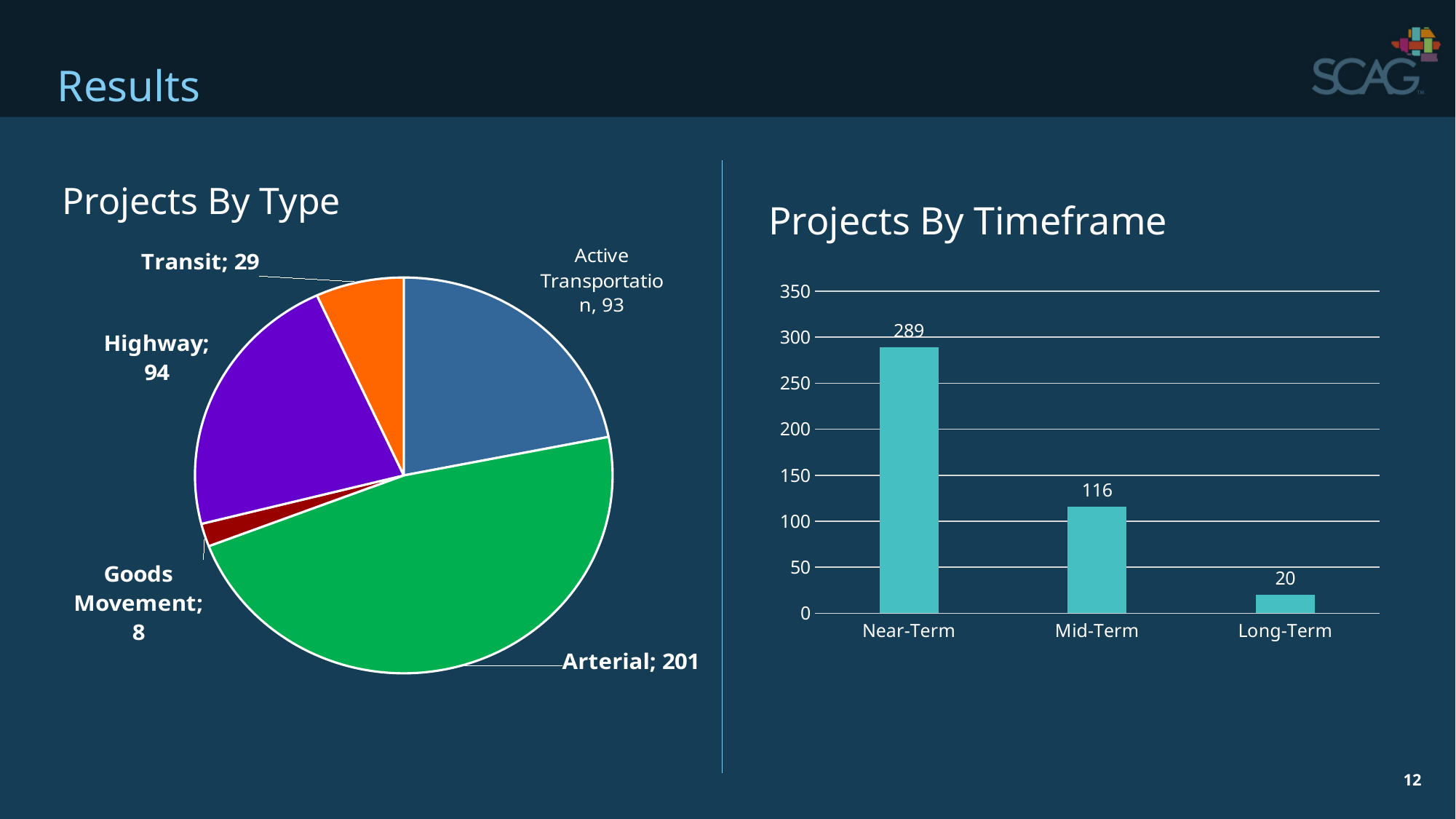
In the Projects By Type pie chart, how many projects are Transit? 29 In the Projects By Timeframe chart, which timeframe has the lowest value? Long-Term In the Projects By Timeframe chart, what is the difference between Near-Term and Long-Term? 269 In the Projects By Type pie chart, what share of all projects is Arterial? 47% In the Projects By Type pie chart, which project type has the smallest slice? Goods Movement In the Projects By Timeframe chart, do the values rise or fall from Near-Term to Long-Term? fall In the Projects By Timeframe chart, what is the value for Mid-Term? 116 In the Projects By Type pie chart, which project type has the largest slice? Arterial What kind of chart is Projects By Timeframe? bar chart In the Projects By Type pie chart, how many projects are Arterial? 201 In the Projects By Type pie chart, what is the difference between the Arterial and Highway values? 107 In the Projects By Type pie chart, how many slices are there? 5